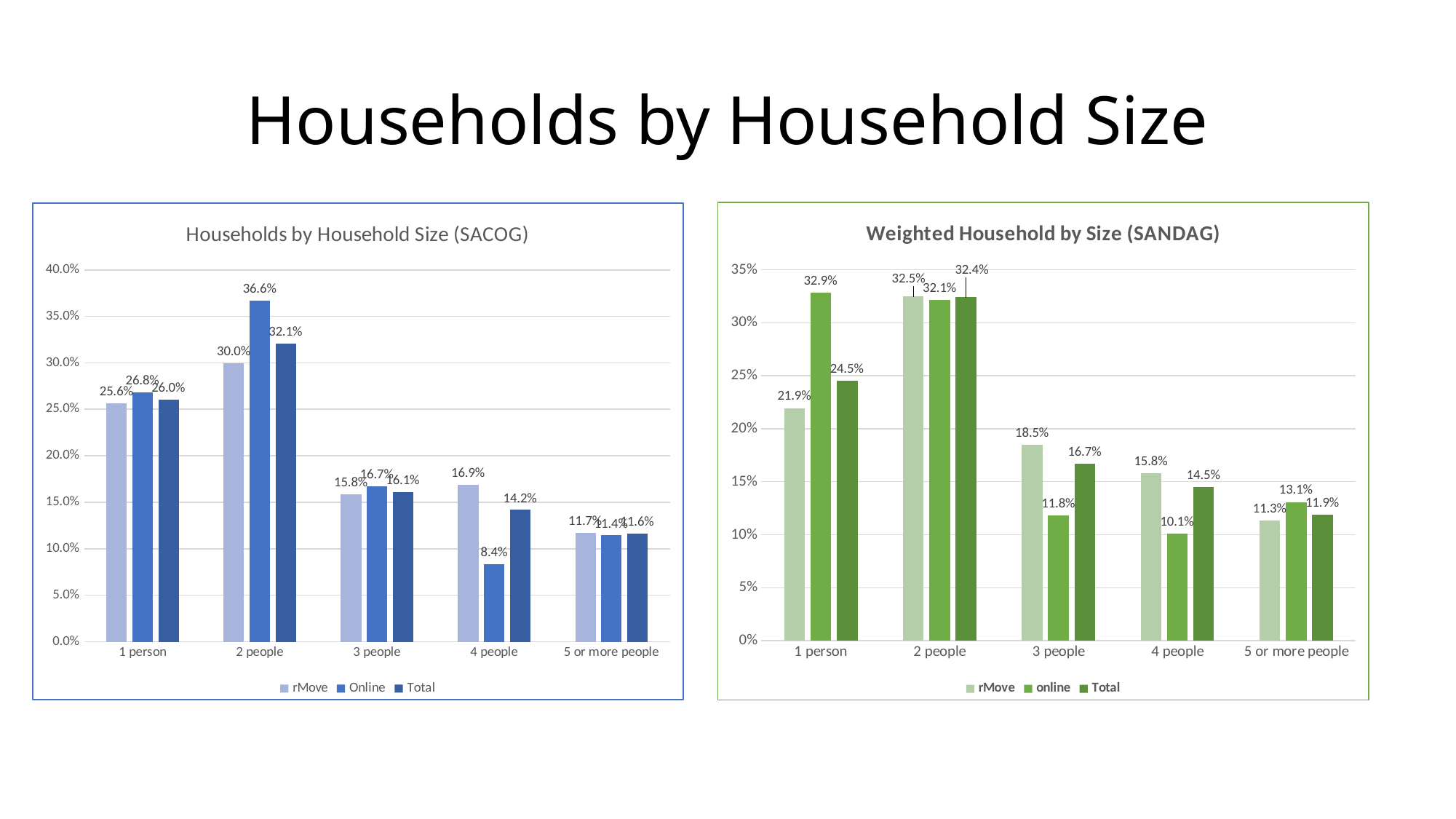
How many series does the legend of the 'Weighted Household by Size (SANDAG)' chart list? 3 In the 'Weighted Household by Size (SANDAG)' chart, which category has the lowest online value? 4 people How many household size categories are shown in the 'Households by Household Size (SACOG)' chart? 5 What kind of chart is the 'Households by Household Size (SACOG)' chart? Bar chart In the 'Households by Household Size (SACOG)' chart, which category has the highest Online value? 2 people In the 'Households by Household Size (SACOG)' chart, what is the Total value for 4 people? 14.2% In the 'Weighted Household by Size (SANDAG)' chart, what is the rMove value for 1 person? 21.9% In the 'Weighted Household by Size (SANDAG)' chart, what is the online value for 4 people? 10.1% In the 'Households by Household Size (SACOG)' chart, what is the Online value for 2 people? 36.6% In the 'Weighted Household by Size (SANDAG)' chart, what is the difference between the online and rMove values for 1 person? 11.0% In the 'Weighted Household by Size (SANDAG)' chart, which is larger for 3 people: the rMove value or the online value? rMove In the 'Households by Household Size (SACOG)' chart, what is the difference between the rMove and Online values for 4 people? 8.5%